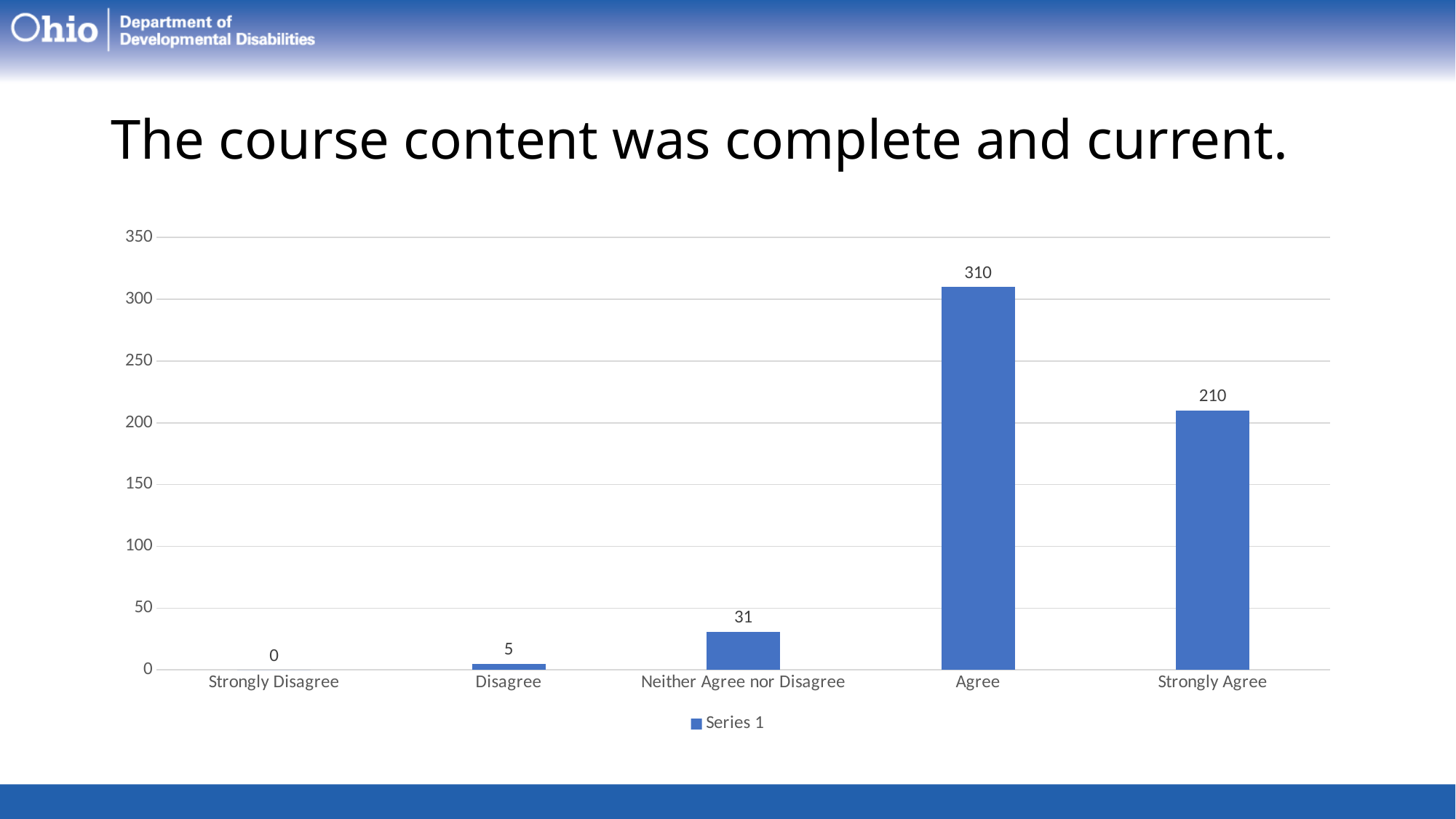
Which category has the lowest value? Strongly Disagree Which category has the highest value? Agree What is the value for Strongly Disagree? 0 Which is larger, the value for Neither Agree nor Disagree or the value for Disagree? Neither Agree nor Disagree What is the value for Strongly Agree? 210 What is the difference between the values for Agree and Strongly Agree? 100 What is the title of the slide above the chart? The course content was complete and current. What kind of chart is shown on the slide? Bar chart How many categories are shown on the x axis? 5 What is the value for Agree? 310 What is the value for Disagree? 5 What is the value for Neither Agree nor Disagree? 31